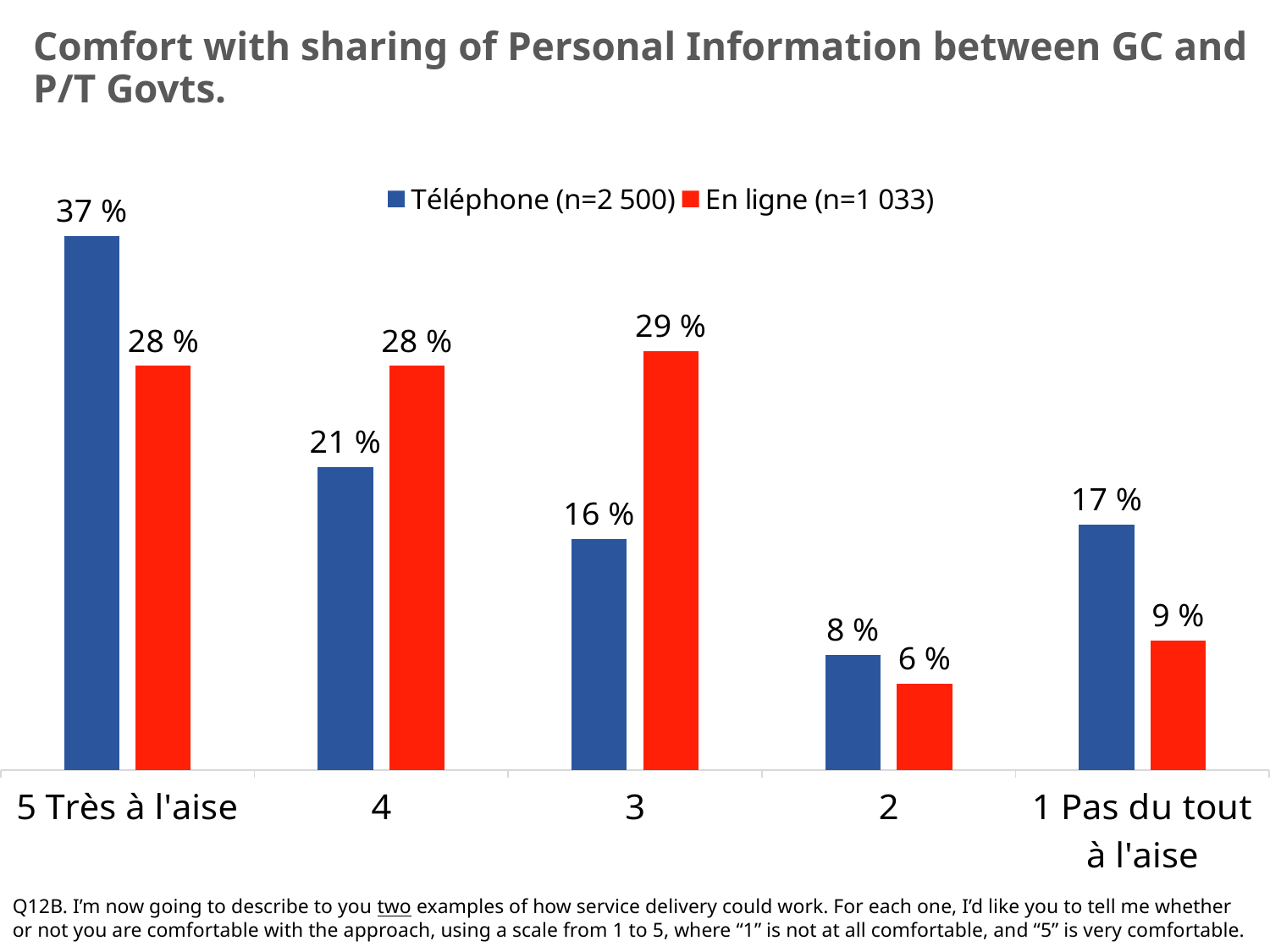
What is the Téléphone (n=2 500) value for the category '5 Très à l'aise'? 37 % Which category has the highest Téléphone (n=2 500) value? 5 Très à l'aise What is the Téléphone (n=2 500) value for the category '1 Pas du tout à l'aise'? 17 % What is the En ligne (n=1 033) value for the category '2'? 6 % What is the En ligne (n=1 033) value for the category '3'? 29 % What kind of chart is shown on the slide? Bar chart What colour are the bars for the En ligne (n=1 033) series? Red How many series does the legend list? 2 How many categories are shown on the x axis? 5 What is the difference between the Téléphone (n=2 500) and En ligne (n=1 033) values for '5 Très à l'aise'? 9 % Which category has the lowest En ligne (n=1 033) value? 2 For the category '4', which series has the larger value, Téléphone (n=2 500) or En ligne (n=1 033)? En ligne (n=1 033)